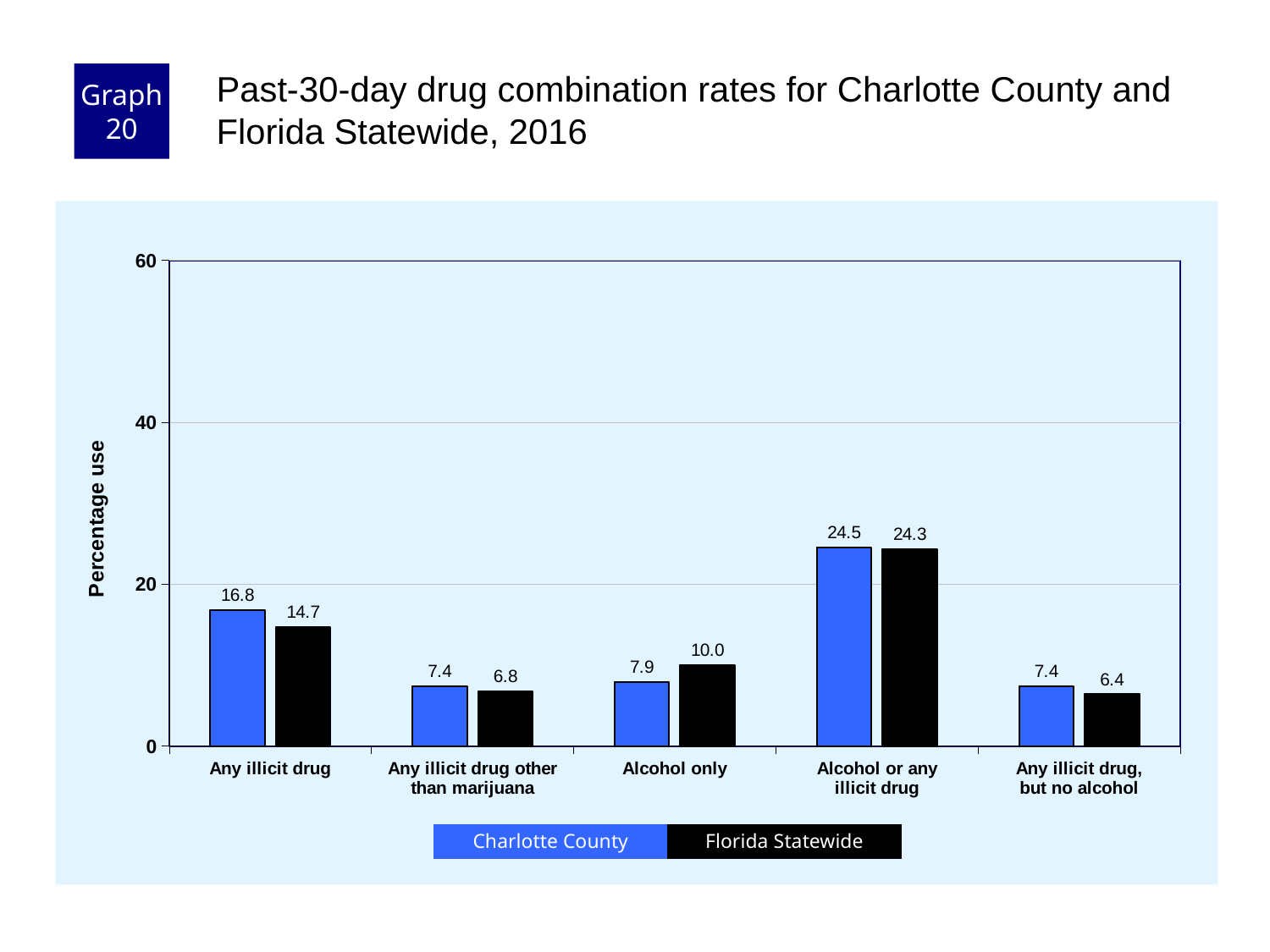
How many series does the legend list? 2 Which is larger for Any illicit drug other than marijuana: Charlotte County or Florida Statewide? Charlotte County How many categories are shown on the x axis? 5 What is the Florida Statewide value for Any illicit drug, but no alcohol? 6.4 What is the Charlotte County value for Any illicit drug? 16.8 Which category has the highest Charlotte County value? Alcohol or any illicit drug Which category has the lowest Florida Statewide value? Any illicit drug, but no alcohol Is the Charlotte County value for Alcohol or any illicit drug greater or less than 20? greater What is the Florida Statewide value for Alcohol only? 10.0 What kind of chart is shown on the slide? Bar chart What is the difference between the Florida Statewide and Charlotte County values for Alcohol only? 2.1 What is the difference between the Charlotte County and Florida Statewide values for Any illicit drug? 2.1